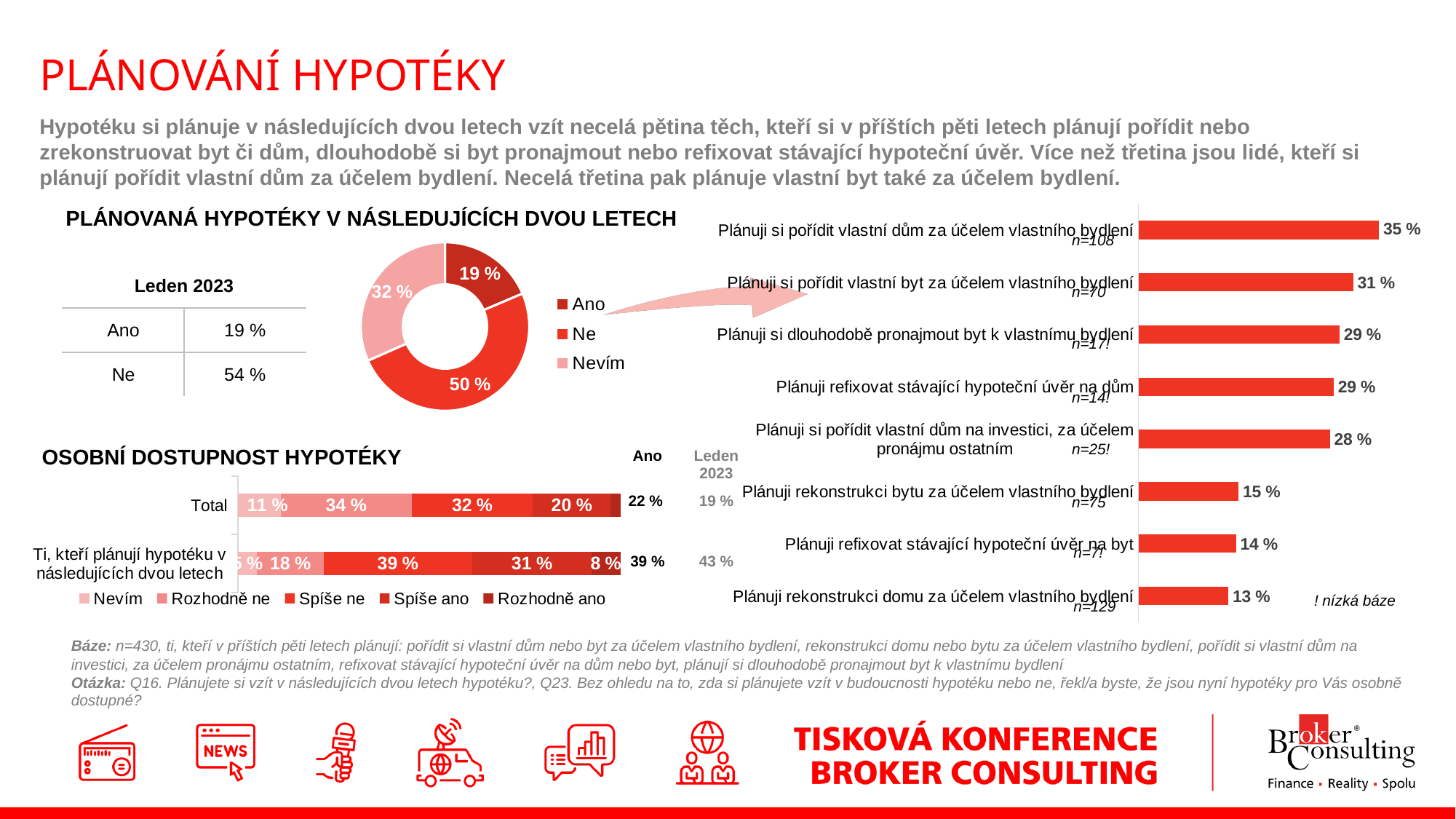
In the stacked bar chart titled 'OSOBNÍ DOSTUPNOST HYPOTÉKY', what is the 'Spíše ano' value for 'Ti, kteří plánují hypotéku v následujících dvou letech'? 31 % In the stacked bar chart titled 'OSOBNÍ DOSTUPNOST HYPOTÉKY', what is the 'Spíše ne' value for 'Total'? 32 % What kind of chart is the one titled 'PLÁNOVANÁ HYPOTÉKY V NÁSLEDUJÍCÍCH DVOU LETECH'? Doughnut (pie) chart In the bar chart on the right side of the slide, what is the difference between 'Plánuji si pořídit vlastní dům za účelem vlastního bydlení' and 'Plánuji si pořídit vlastní byt za účelem vlastního bydlení'? 4 percentage points In the doughnut chart titled 'PLÁNOVANÁ HYPOTÉKY V NÁSLEDUJÍCÍCH DVOU LETECH', how many entries does the legend list? 3 In the bar chart on the right side of the slide, which category has the highest value? Plánuji si pořídit vlastní dům za účelem vlastního bydlení In the doughnut chart titled 'PLÁNOVANÁ HYPOTÉKY V NÁSLEDUJÍCÍCH DVOU LETECH', which category has the largest share? Ne In the doughnut chart titled 'PLÁNOVANÁ HYPOTÉKY V NÁSLEDUJÍCÍCH DVOU LETECH', what is the value for 'Ne'? 50 % In the stacked bar chart titled 'OSOBNÍ DOSTUPNOST HYPOTÉKY', how many entries does the legend list? 5 In the stacked bar chart titled 'OSOBNÍ DOSTUPNOST HYPOTÉKY', how much higher is the 'Spíše ne' value for 'Ti, kteří plánují hypotéku v následujících dvou letech' than for 'Total'? 7 percentage points In the bar chart on the right side of the slide, what is the value for 'Plánuji rekonstrukci domu za účelem vlastního bydlení'? 13 % How many categories are shown in the bar chart on the right side of the slide? 8